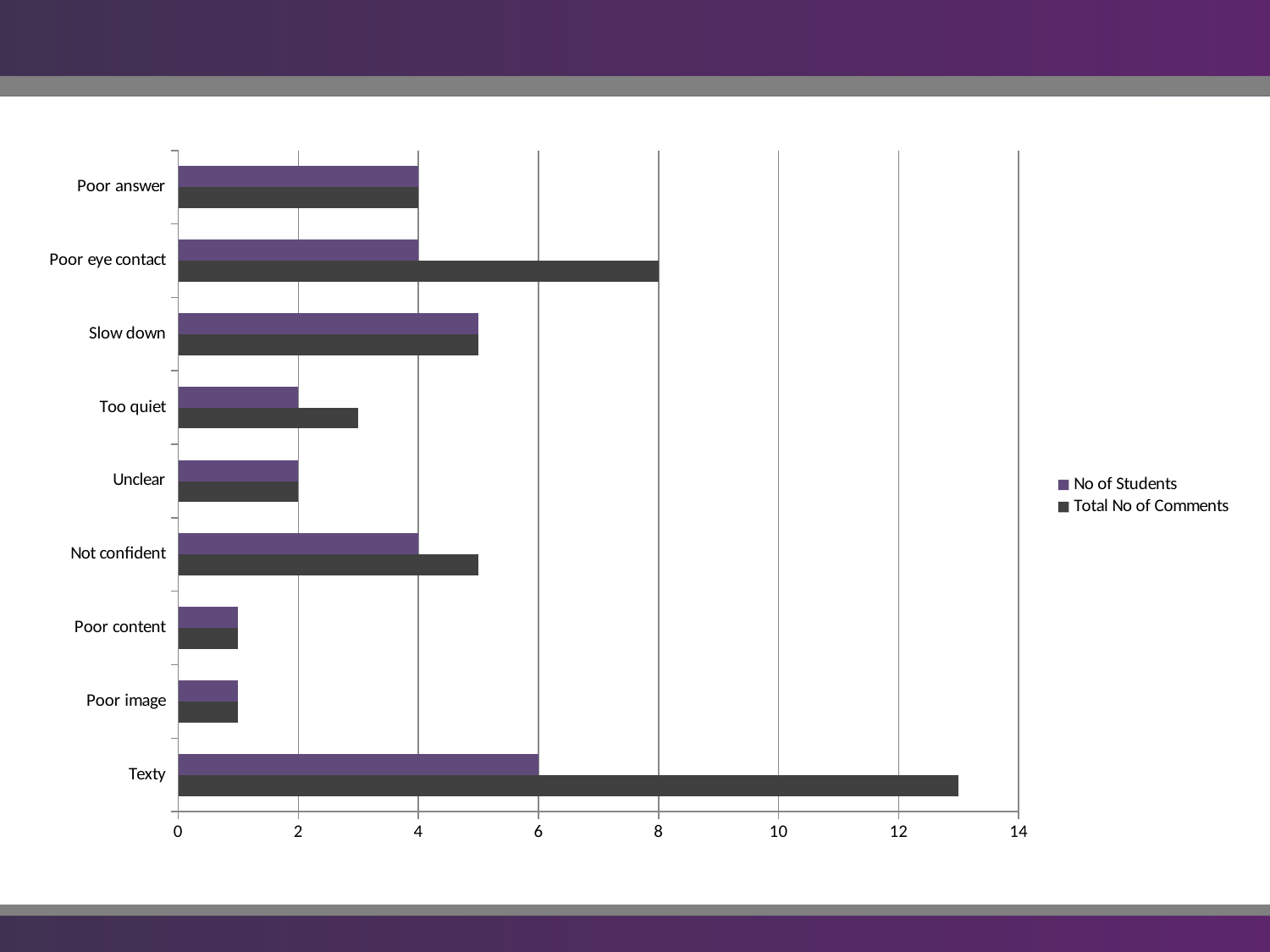
What is the Total No of Comments value for Unclear? 2 What type of chart is shown on the slide? Bar chart How many series does the legend list? 2 What is the No of Students value for Texty? 6 What is the Total No of Comments value for Poor eye contact? 8 How many categories are shown on the vertical axis? 9 What is the difference between Total No of Comments and No of Students for Poor eye contact? 4 Which colour represents the No of Students series in the legend? Purple Is the Total No of Comments value for Texty greater or less than 12? greater Which category has the highest Total No of Comments? Texty What is the No of Students value for Poor answer? 4 Is the Total No of Comments value for Poor content greater or less than 2? less